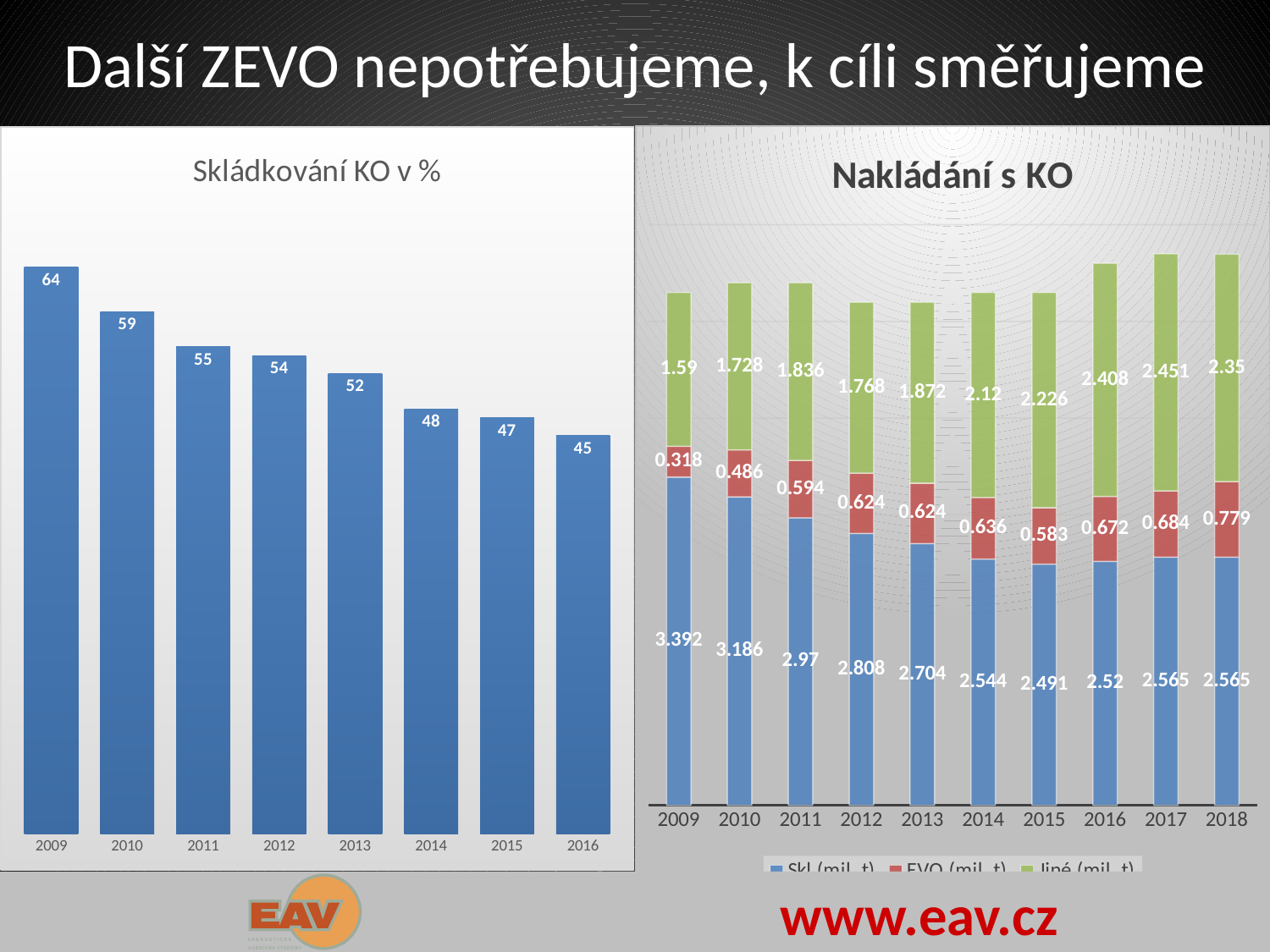
In the 'Skládkování KO v %' chart, do the values rise or fall from 2009 to 2016? fall What kind of chart is the 'Skládkování KO v %' chart? bar chart In the 'Skládkování KO v %' chart, what is the value for 2009? 64 In the 'Nakládání s KO' chart, which is larger: the green segment for 2014 or the green segment for 2009? 2014 In the 'Skládkování KO v %' chart, what is the difference between the values for 2009 and 2016? 19 In the 'Nakládání s KO' chart, what is the value of the red (EVO) segment for 2018? 0.779 In the 'Nakládání s KO' chart, what is the total of the stacked bar for 2009? 5.3 In the 'Skládkování KO v %' chart, which year has the lowest value? 2016 In the 'Nakládání s KO' chart, how many series does the legend list? 3 In the 'Skládkování KO v %' chart, how many years are shown? 8 In the 'Nakládání s KO' chart, what is the value of the green (Jiné) segment for 2017? 2.451 In the 'Nakládání s KO' chart, what is the value of the blue (Skl) segment for 2009? 3.392